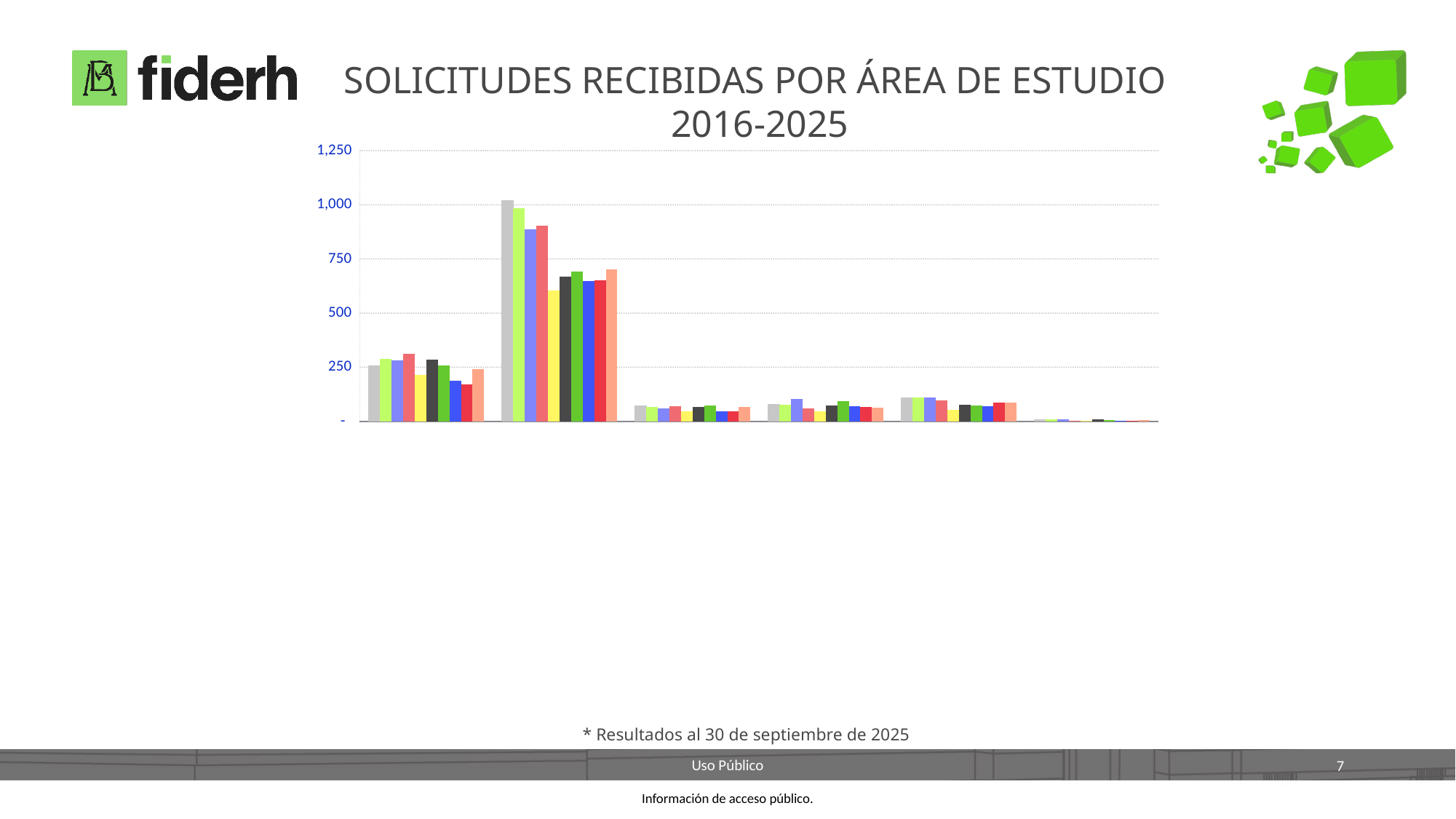
What is the highest value shown on the vertical axis? 1,250 Which group of bars, counting from the left, has the tallest bars? the second group Is the yellow bar in the second group from the left greater or less than 750? less Which group of bars, counting from the left, has the lowest bars? the sixth (rightmost) group What kind of chart is shown on the slide? bar chart Are the bars in the third group from the left greater or less than 250? less How many bars are there in each group? 10 What is the title of the chart? SOLICITUDES RECIBIDAS POR ÁREA DE ESTUDIO 2016-2025 How many groups of bars are plotted along the x axis? 6 Is the tallest bar in the second group from the left greater or less than 1,000? greater Which has taller bars, the third group from the left or the fifth group from the left? the fifth group In the second group from the left, is the first bar taller or shorter than the last bar? taller